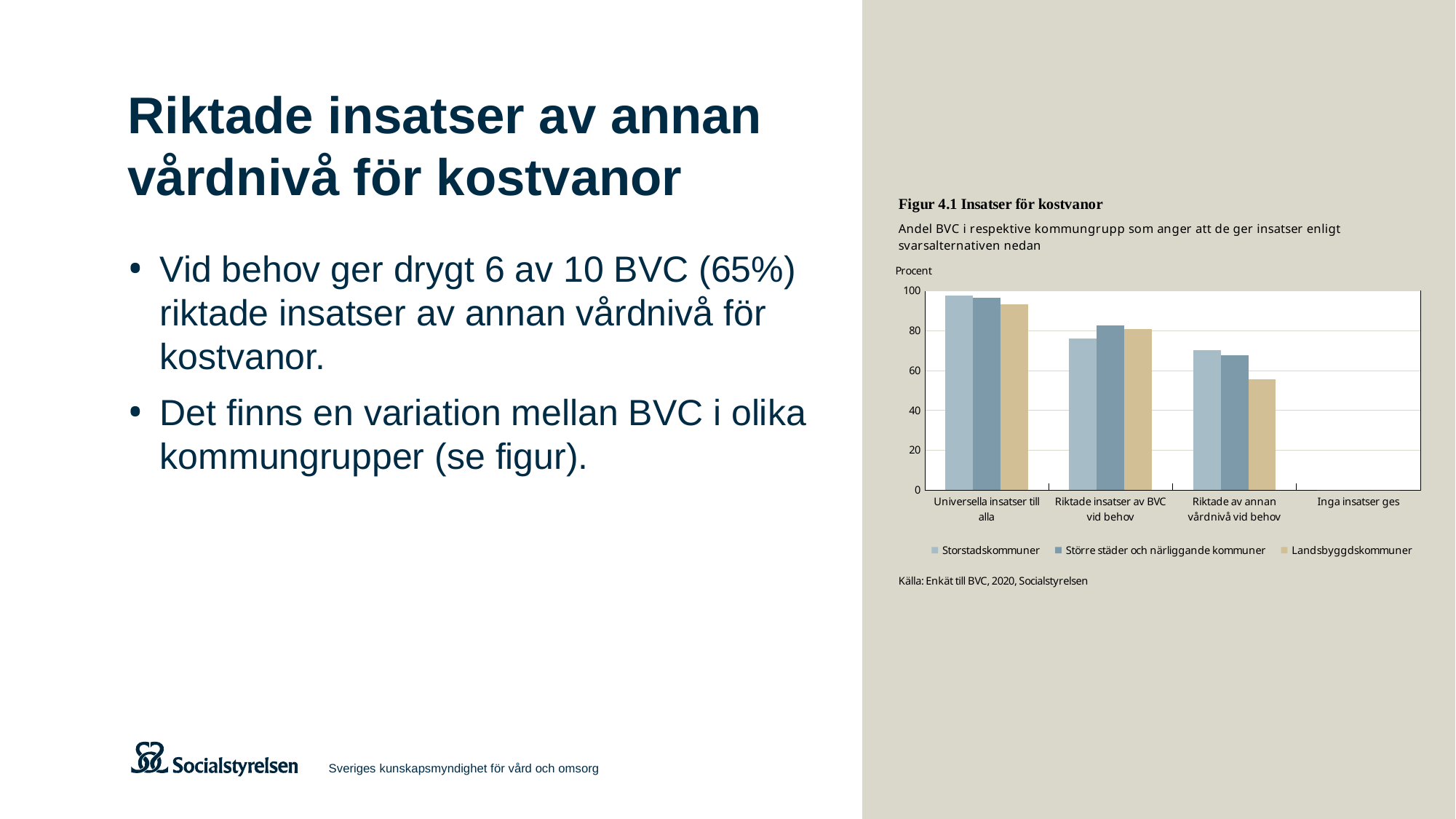
In the category 'Riktade av annan vårdnivå vid behov', which series has the lowest value? Landsbyggdskommuner Is the value for Storstadskommuner in the category 'Riktade insatser av BVC vid behov' greater or less than 80? less Is the value for Landsbyggdskommuner in the category 'Riktade av annan vårdnivå vid behov' greater or less than 60? less What kind of chart is shown on the slide? Bar chart In the category 'Riktade av annan vårdnivå vid behov', which is larger: Storstadskommuner or Landsbyggdskommuner? Storstadskommuner How many categories are shown on the x axis of the chart? 4 Which category has the highest values across all three series? Universella insatser till alla In the category 'Riktade insatser av BVC vid behov', which is larger: Storstadskommuner or Större städer och närliggande kommuner? Större städer och närliggande kommuner Is the value for Storstadskommuner in the category 'Universella insatser till alla' greater or less than 80? greater How many series does the legend of the chart list? 3 What unit is shown on the y axis of the chart? Procent